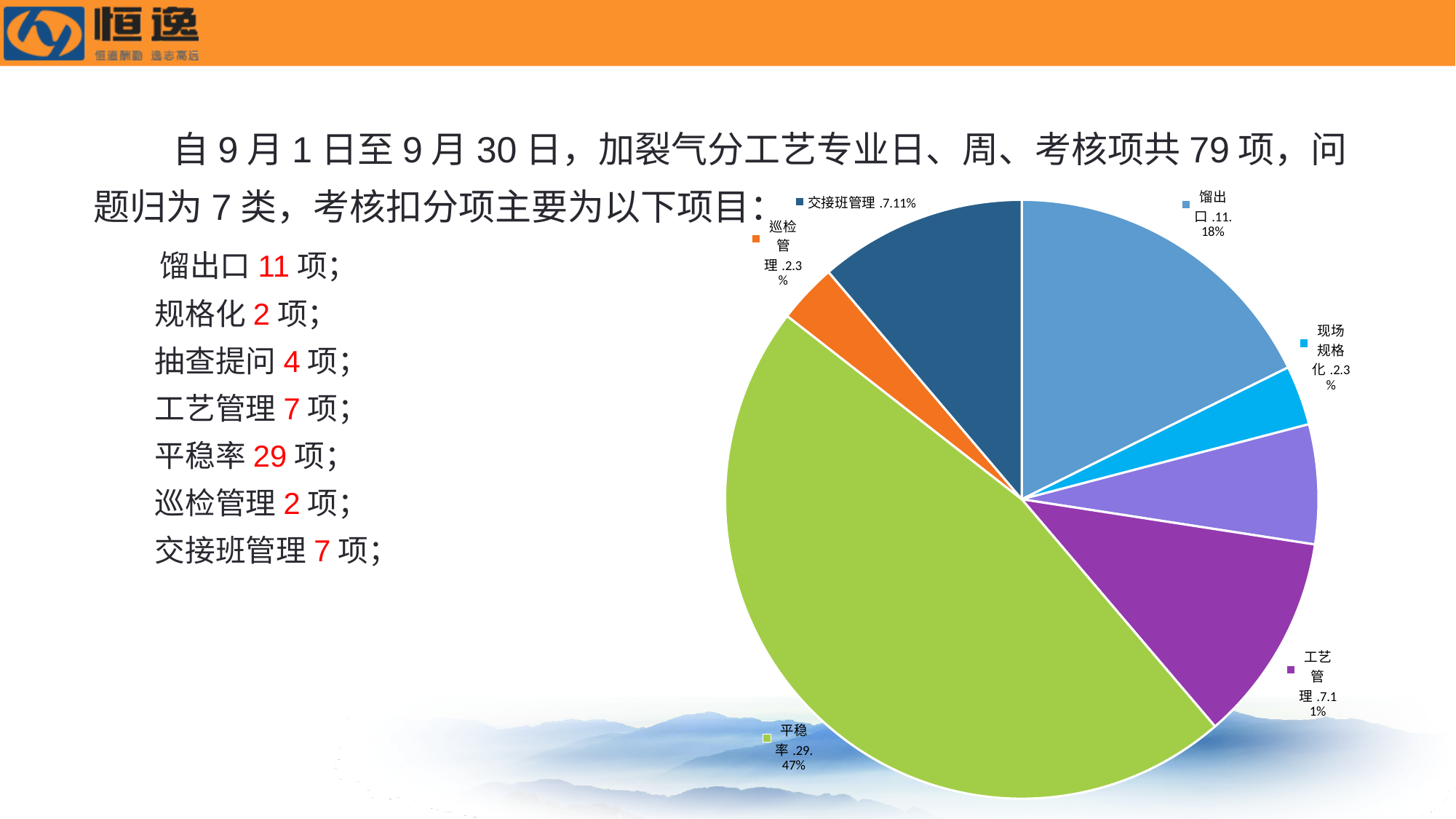
What percentage is shown on the data label for 平稳率? 47% What percentage is shown on the data label for 工艺管理? 11% What colour is the 平稳率 slice in the pie chart? green Which slice is larger, 馏出口 or 工艺管理? 馏出口 How many slices does the pie chart have? 7 What value is shown on the data label for 平稳率? 29 What value is shown on the data label for 馏出口? 11 What kind of chart is shown on the slide? pie chart What percentage is shown on the data label for 馏出口? 18% What is the difference between the values for 平稳率 and 馏出口? 18 Which category has the largest slice in the pie chart? 平稳率